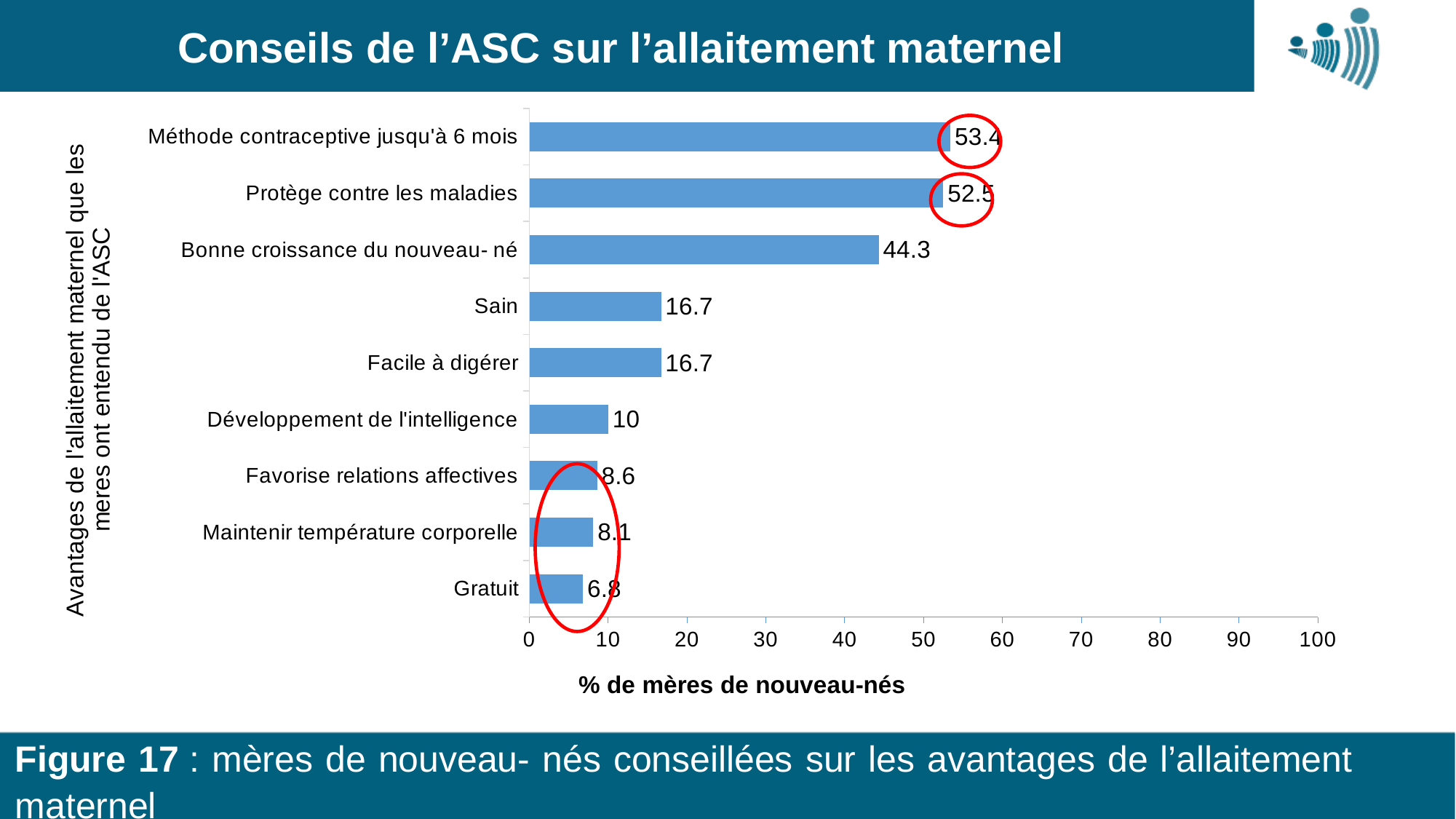
What is the value for "Développement de l'intelligence"? 10 What is the value for "Bonne croissance du nouveau- né"? 44.3 What is the difference between the values for "Protège contre les maladies" and "Bonne croissance du nouveau- né"? 8.2 How many categories are shown in the chart? 9 Which category has the highest value? Méthode contraceptive jusqu'à 6 mois What kind of chart is shown on the slide? bar chart What is the difference between the values for "Facile à digérer" and "Gratuit"? 9.9 What is the value for "Méthode contraceptive jusqu'à 6 mois"? 53.4 Is the value for "Sain" greater or less than 20? less Which category has the lowest value? Gratuit Which is larger, the value for "Favorise relations affectives" or the value for "Maintenir température corporelle"? Favorise relations affectives What is the label of the horizontal axis? % de mères de nouveau-nés